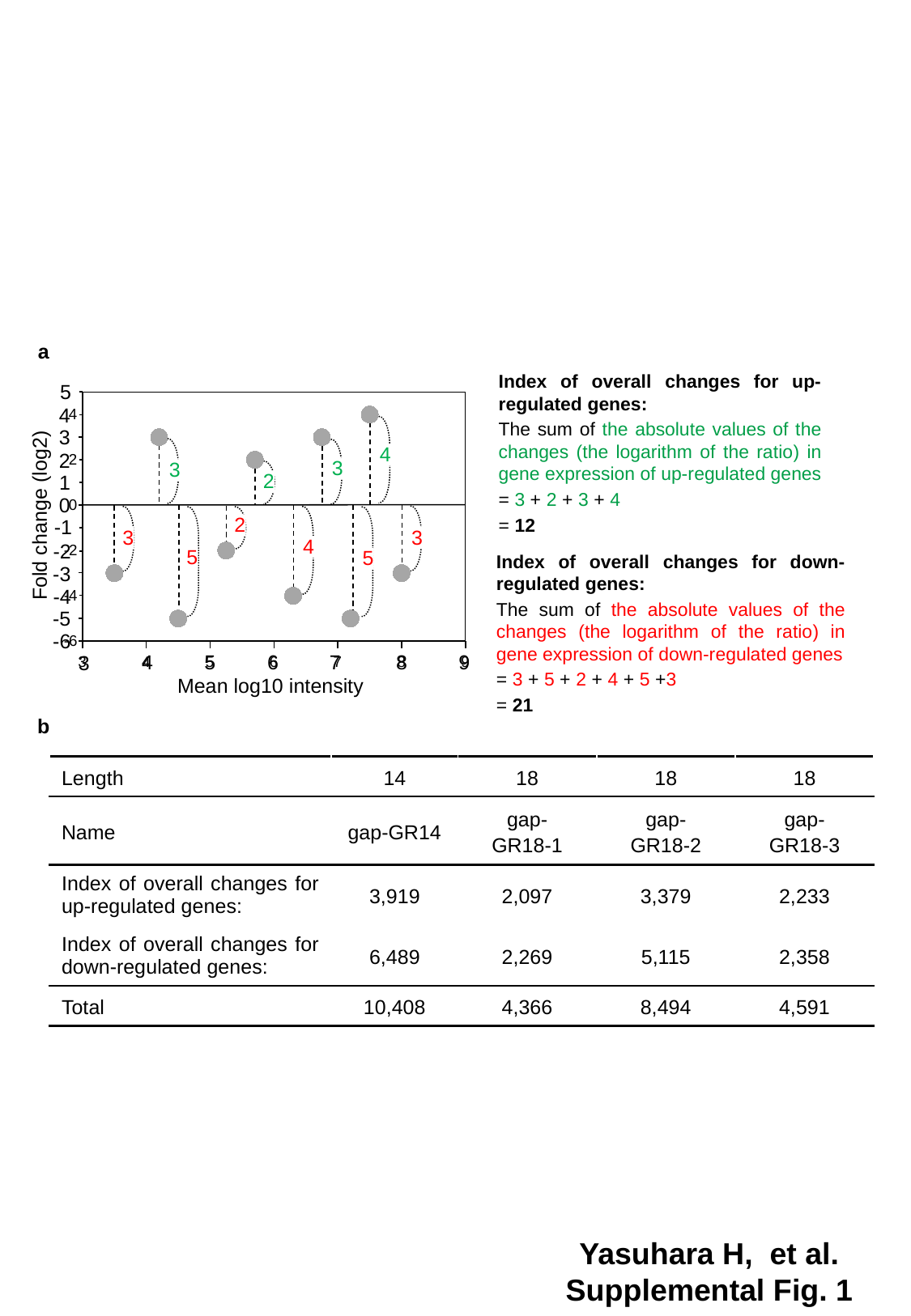
What is the highest fold change (log2) value reached by any point in the chart in panel a? 4 How many data points are plotted in the chart in panel a? 10 What is the smallest absolute change labelled in green in the chart in panel a? 2 According to the text beside the chart in panel a, what is the index of overall changes for up-regulated genes? 12 In the chart in panel a, how many points lie above the zero line (up-regulated genes)? 4 What kind of chart is shown in panel a? scatter chart In the chart in panel a, how many points lie below the zero line (down-regulated genes)? 6 According to the text beside the chart in panel a, what is the index of overall changes for down-regulated genes? 21 What is the x-axis label of the chart in panel a? Mean log10 intensity Which is larger in panel a: the index of overall changes for up-regulated genes or for down-regulated genes? down-regulated genes What is the difference between the largest and smallest green-labelled changes in the chart in panel a? 2 What is the largest absolute change labelled in red in the chart in panel a? 5